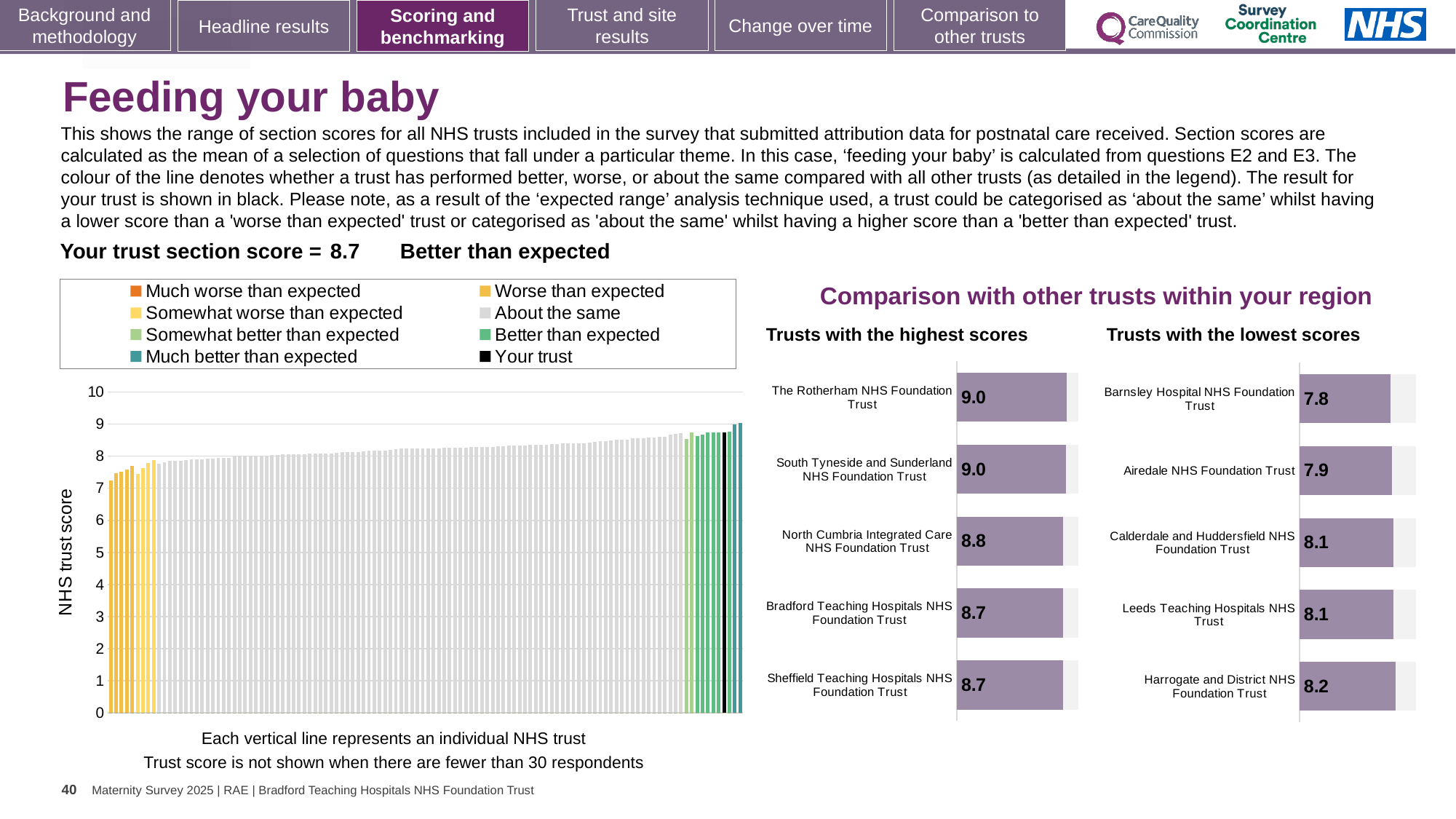
In the 'Trusts with the lowest scores' chart, which trust has the highest score? Harrogate and District NHS Foundation Trust In the 'Trusts with the lowest scores' chart, which has the higher score: Airedale NHS Foundation Trust or Calderdale and Huddersfield NHS Foundation Trust? Calderdale and Huddersfield NHS Foundation Trust In the 'Trusts with the lowest scores' chart, which trust has the lowest score? Barnsley Hospital NHS Foundation Trust In the large 'NHS trust score' chart on the left, what is the section score for your trust? 8.7 In the large 'NHS trust score' chart on the left, what colour is used for the bar representing your trust? Black In the 'Trusts with the lowest scores' chart, what is the difference between the scores of Harrogate and District NHS Foundation Trust and Barnsley Hospital NHS Foundation Trust? 0.4 In the 'Trusts with the lowest scores' chart, what is the score for Harrogate and District NHS Foundation Trust? 8.2 How many entries does the legend above the large 'NHS trust score' chart list? 8 In the 'Trusts with the highest scores' chart, what is the score for North Cumbria Integrated Care NHS Foundation Trust? 8.8 What kind of chart is the large 'NHS trust score' chart on the left of the slide? Bar chart How many trusts are shown in the 'Trusts with the highest scores' chart? 5 In the large 'NHS trust score' chart on the left, do the values rise or fall from left to right? Rise